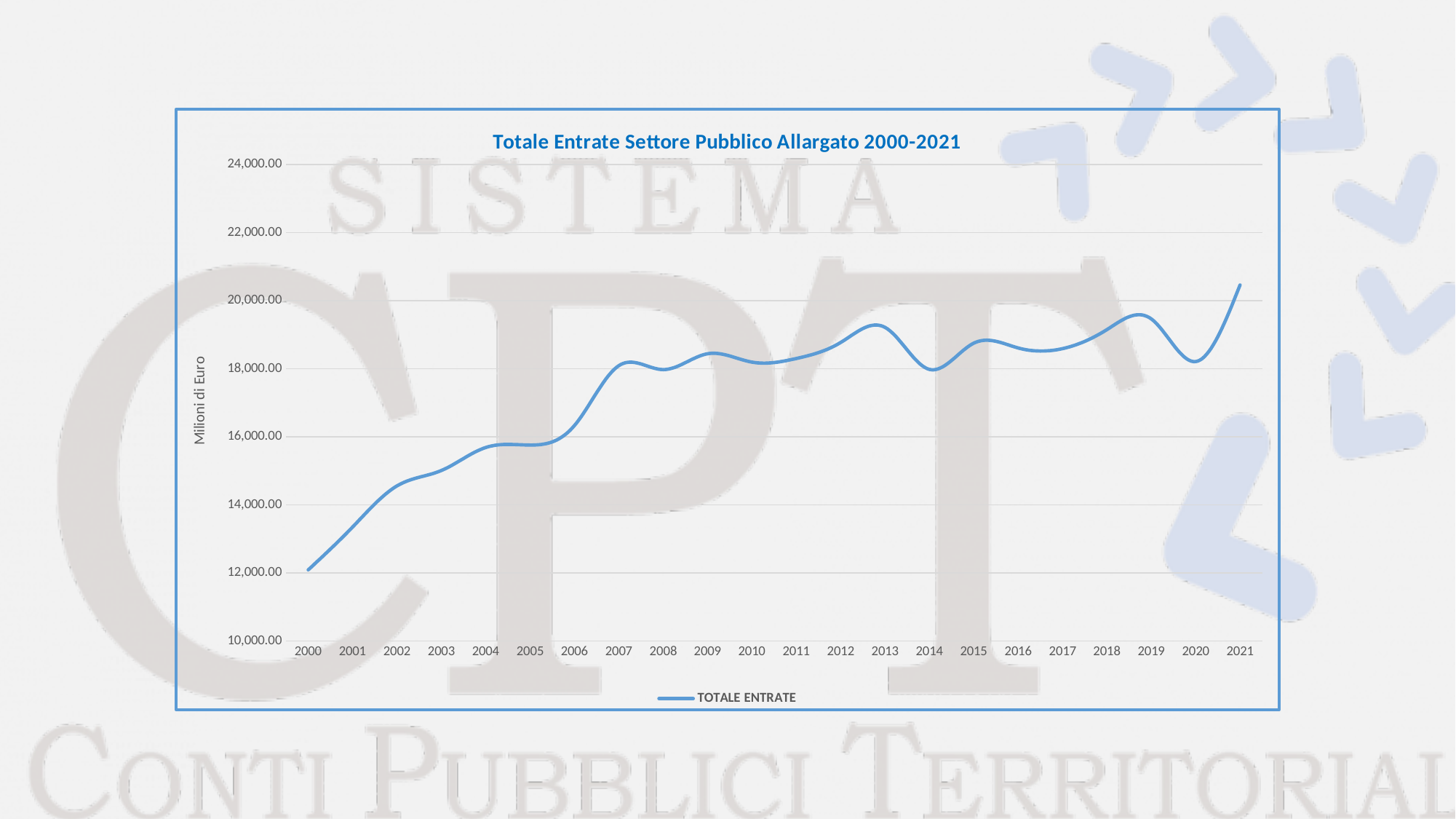
Is the value for 2002 greater or less than 14,000.00? greater Is the value for 2021 greater or less than 20,000.00? greater Which year has the larger value, 2013 or 2014? 2013 Which year has the lowest value for TOTALE ENTRATE? 2000 What kind of chart is shown on the slide? line chart How many years are plotted along the x axis? 22 What is the title of the chart? Totale Entrate Settore Pubblico Allargato 2000-2021 Is the value for 2005 greater or less than 16,000.00? less How many series does the legend list? 1 Does the value for TOTALE ENTRATE overall rise or fall from 2000 to 2021? rise What is the label of the y axis? Milioni di Euro Which year has the highest value for TOTALE ENTRATE? 2021